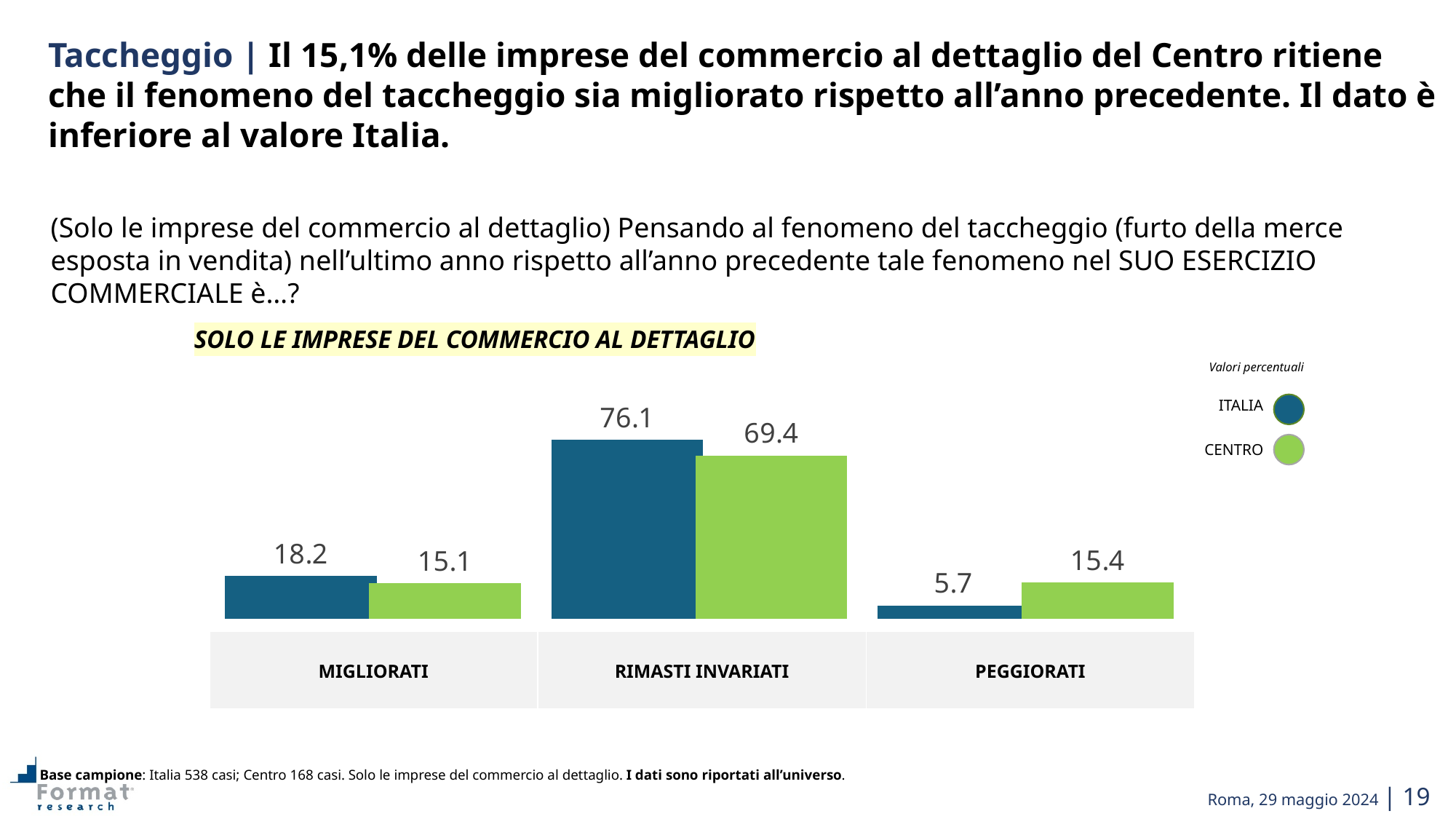
Which category has the highest ITALIA value? RIMASTI INVARIATI What is the CENTRO value for RIMASTI INVARIATI? 69.4 What is the ITALIA value for MIGLIORATI? 18.2 What kind of chart is shown on the slide? Bar chart What is the ITALIA value for PEGGIORATI? 5.7 For MIGLIORATI, which series has the larger value, ITALIA or CENTRO? ITALIA How many series does the legend list? 2 What is the difference between the CENTRO and ITALIA values for PEGGIORATI? 9.7 What is the difference between the ITALIA and CENTRO values for RIMASTI INVARIATI? 6.7 Which category has the lowest CENTRO value? MIGLIORATI How many categories are shown on the x axis? 3 What is the CENTRO value for PEGGIORATI? 15.4